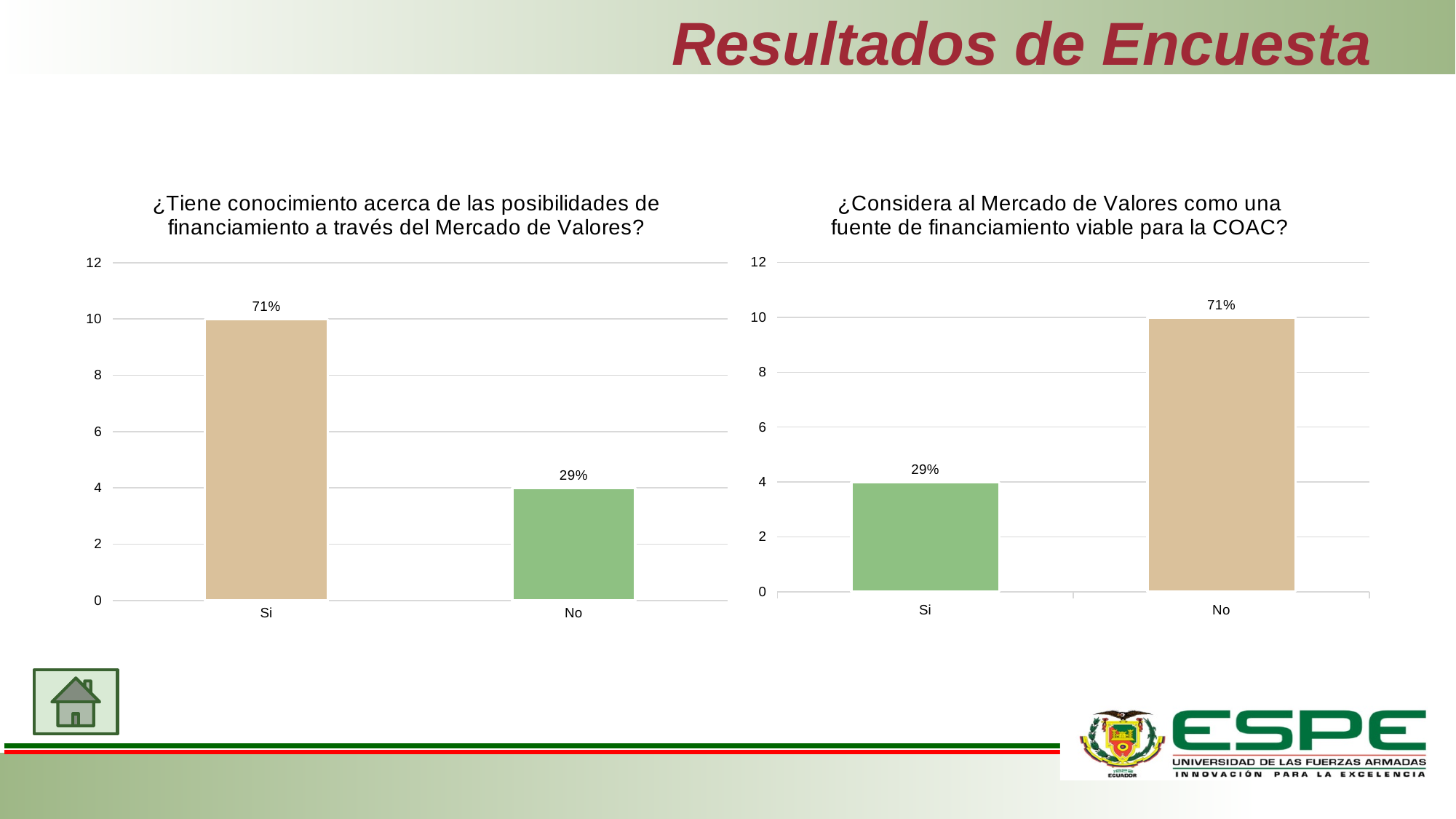
In the right chart, which category has the lowest bar? Si In the right chart, is the bar for 'No' greater or less than 8 on the vertical axis? greater In the left chart (¿Tiene conocimiento acerca de las posibilidades de financiamiento a través del Mercado de Valores?), what is the data label shown for 'No'? 29% In the left chart (¿Tiene conocimiento acerca de las posibilidades de financiamiento a través del Mercado de Valores?), what is the data label shown for 'Si'? 71% In the right chart (¿Considera al Mercado de Valores como una fuente de financiamiento viable para la COAC?), what is the data label shown for 'No'? 71% What type of chart is the left chart? Bar chart In the right chart (¿Considera al Mercado de Valores como una fuente de financiamiento viable para la COAC?), what is the data label shown for 'Si'? 29% In the left chart, which category has the highest bar? Si In the left chart, is the bar for 'No' greater or less than 6 on the vertical axis? less In the right chart, which is larger, the value for 'Si' or the value for 'No'? No How many categories are shown on the x axis of the right chart? 2 In the left chart, what is the difference in percentage points between the 'Si' and 'No' labels? 42%